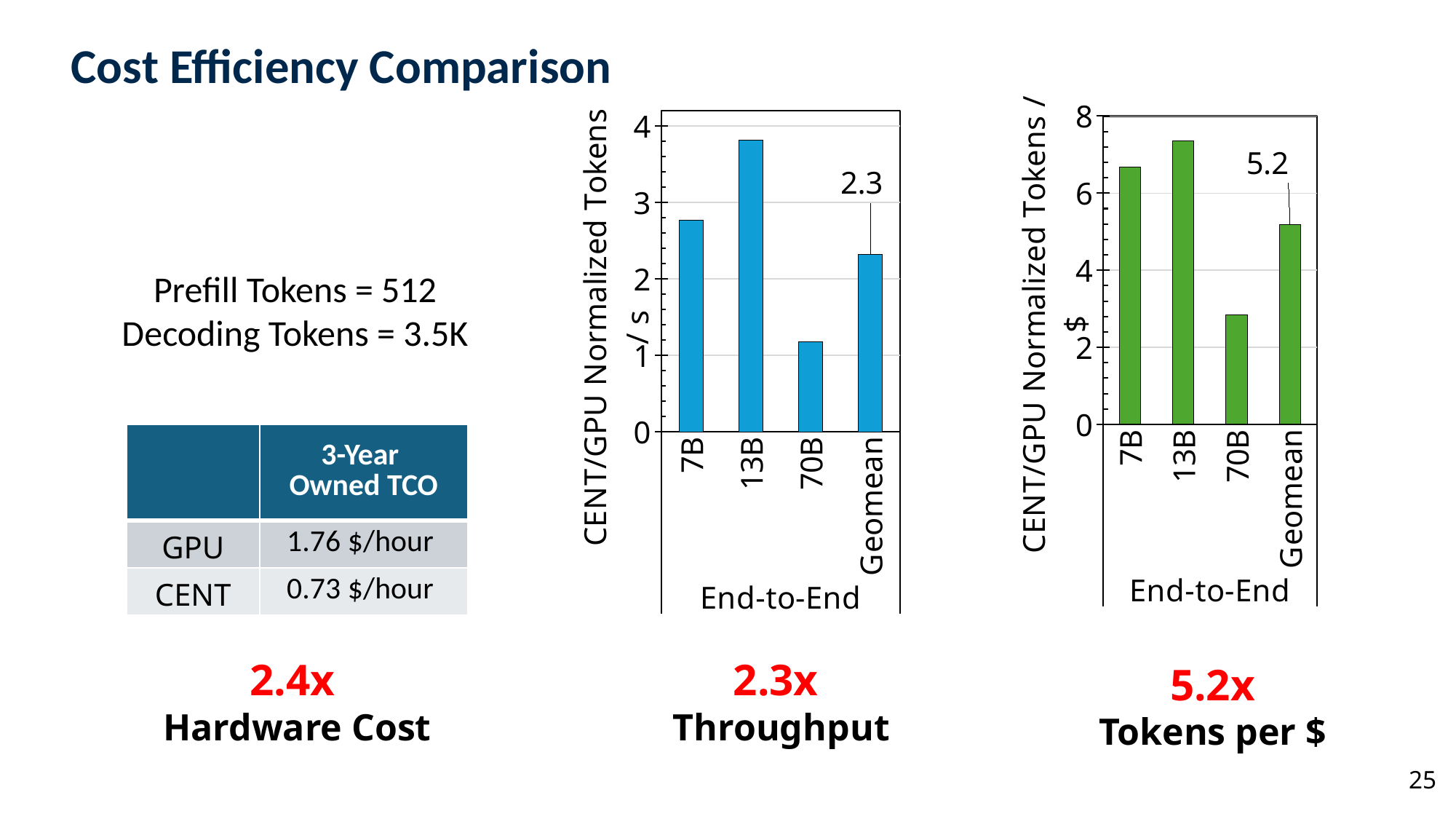
In the green chart (CENT/GPU Normalized Tokens / $), is the value for 70B greater or less than 4? less In the blue chart (CENT/GPU Normalized Tokens / s), which category has the highest bar? 13B How many categories are shown on the x axis of the blue chart (CENT/GPU Normalized Tokens / s)? 4 In the green chart (CENT/GPU Normalized Tokens / $), what is the labeled value for Geomean? 5.2 In the green chart (CENT/GPU Normalized Tokens / $), which category has the lowest bar? 70B In the green chart (CENT/GPU Normalized Tokens / $), which category has the highest bar? 13B What type of chart is the green chart (CENT/GPU Normalized Tokens / $)? Bar chart In the green chart (CENT/GPU Normalized Tokens / $), which is larger, the bar for 7B or the bar for Geomean? 7B In the blue chart (CENT/GPU Normalized Tokens / s), which category has the lowest bar? 70B In the blue chart (CENT/GPU Normalized Tokens / s), which is larger, the bar for 7B or the bar for 70B? 7B In the blue chart (CENT/GPU Normalized Tokens / s), is the value for 13B greater or less than 3? greater In the blue chart (CENT/GPU Normalized Tokens / s), what is the labeled value for Geomean? 2.3